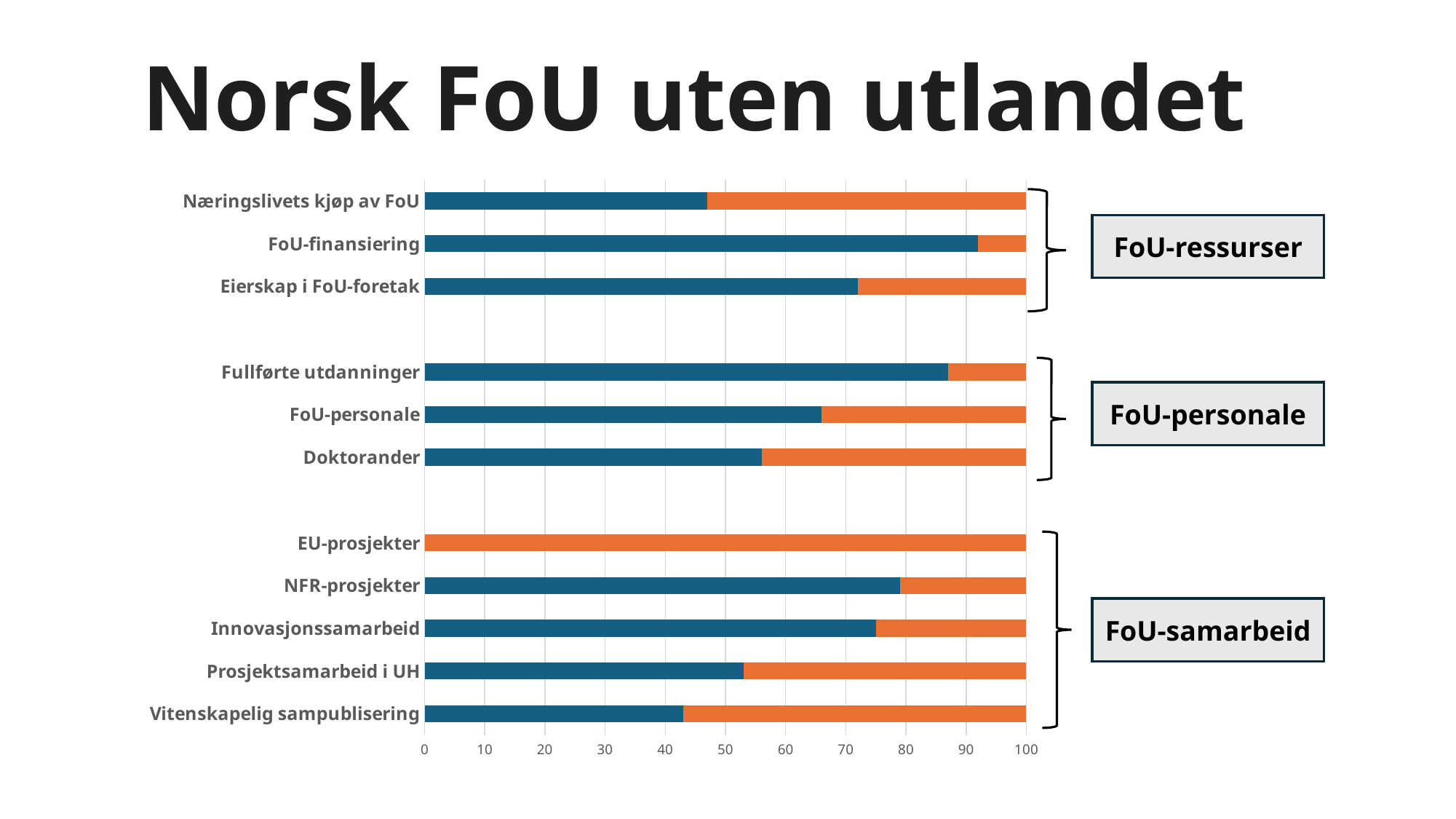
Which category has no blue segment at all (the bar is entirely orange)? EU-prosjekter Is the blue segment for FoU-finansiering greater or less than 90? greater Is the blue segment for Vitenskapelig sampublisering greater or less than 50? less Is the blue segment for Doktorander greater or less than 50? greater Which has the larger blue segment, Fullførte utdanninger or FoU-personale? Fullførte utdanninger What kind of chart is shown on the slide? Stacked bar chart How many categories (bars) are plotted in the chart? 11 Which category has the longest blue segment? FoU-finansiering What are the three group labels shown to the right of the chart? FoU-ressurser, FoU-personale, FoU-samarbeid What is the total length of each stacked bar, as read on the x axis? 100 Which has the larger blue segment, Eierskap i FoU-foretak or Prosjektsamarbeid i UH? Eierskap i FoU-foretak